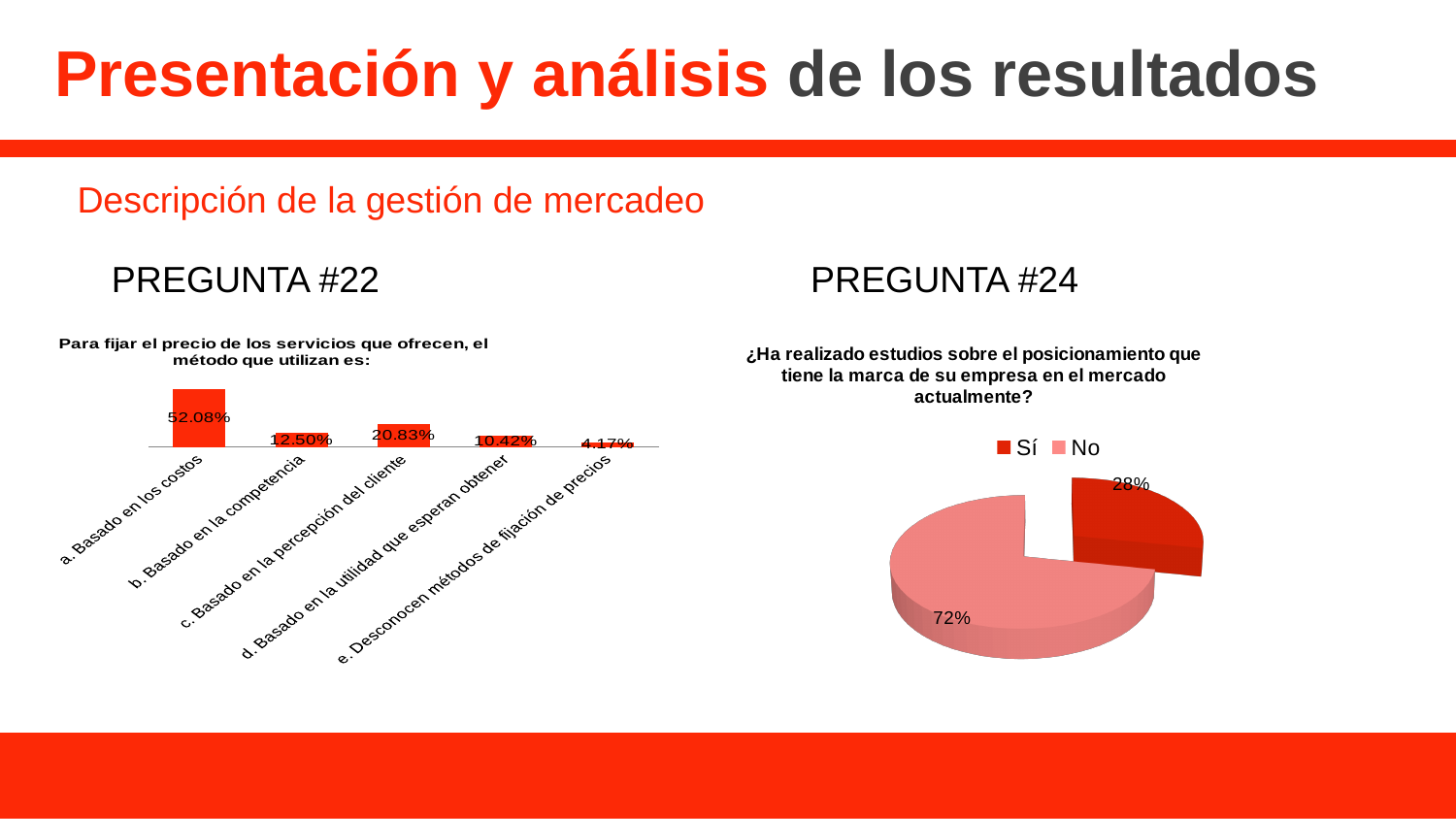
What kind of chart is used for Pregunta #22? Bar chart How many entries does the legend of the Pregunta #24 pie chart list? 2 In the Pregunta #22 bar chart, what is the value for 'e. Desconocen métodos de fijación de precios'? 4.17% In the Pregunta #22 bar chart, what is the difference between 'a. Basado en los costos' and 'c. Basado en la percepción del cliente'? 31.25% In the Pregunta #24 pie chart, what share of respondents answered 'Sí'? 28% In the Pregunta #24 pie chart, what share of respondents answered 'No'? 72% In the Pregunta #22 bar chart, which is larger: 'b. Basado en la competencia' or 'd. Basado en la utilidad que esperan obtener'? b. Basado en la competencia In the Pregunta #22 bar chart, what is the value for 'a. Basado en los costos'? 52.08% In the Pregunta #22 bar chart, which category has the lowest value? e. Desconocen métodos de fijación de precios How many categories are shown in the Pregunta #22 bar chart? 5 In the Pregunta #22 bar chart, which category has the highest value? a. Basado en los costos In the Pregunta #22 bar chart, what is the value for 'c. Basado en la percepción del cliente'? 20.83%